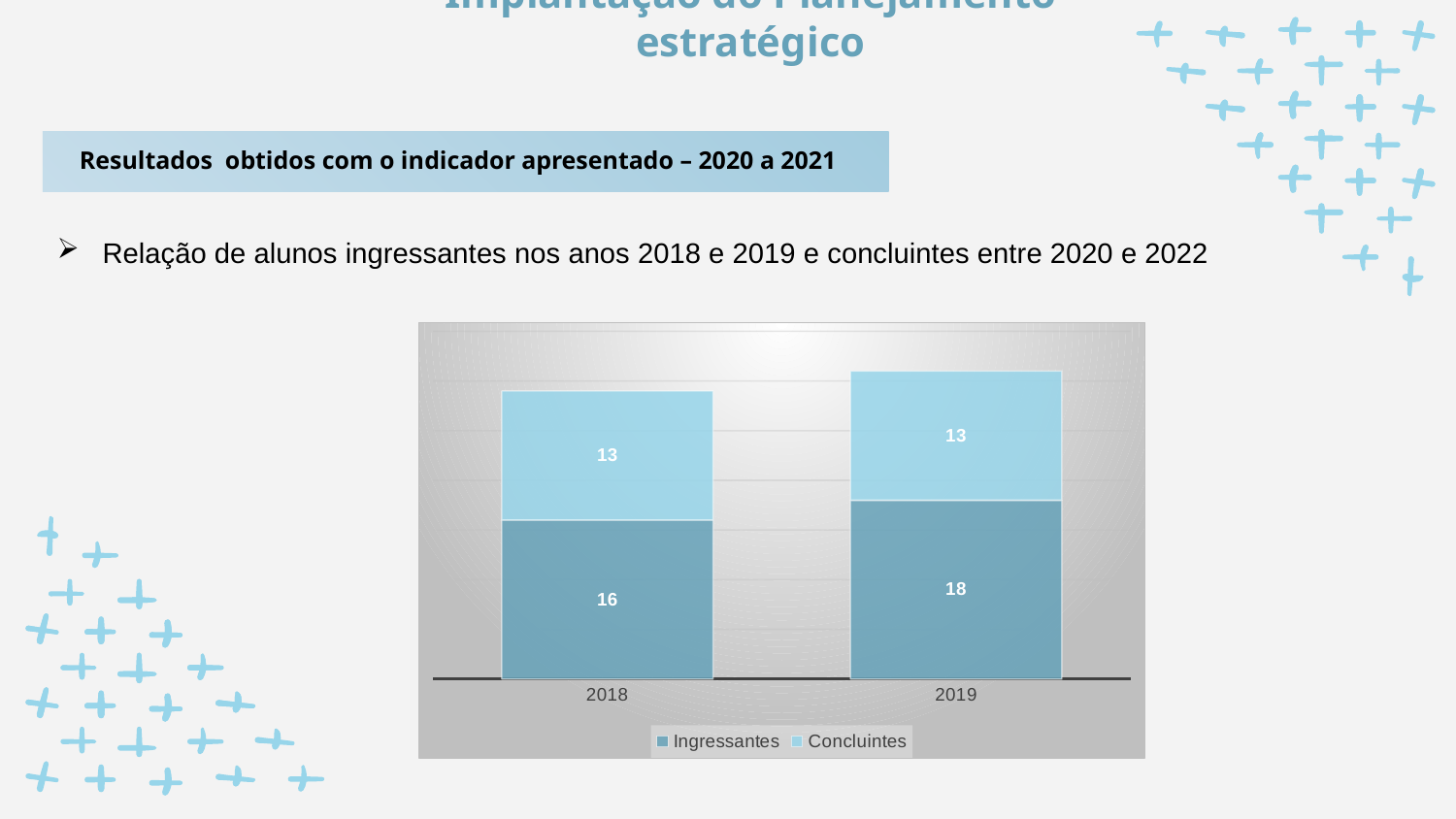
What is the value for Ingressantes in 2019? 18 How many series does the legend list? 2 What is the difference between Ingressantes in 2019 and Ingressantes in 2018? 2 What kind of chart is shown on the slide? Stacked bar chart What is the value for Concluintes in 2019? 13 Which series is shown in the darker blue colour? Ingressantes What is the value for Concluintes in 2018? 13 What is the total of the stacked bar for 2018? 29 What is the total of the stacked bar for 2019? 31 How many categories are shown on the x axis? 2 What is the value for Ingressantes in 2018? 16 Which year has the higher value for Ingressantes, 2018 or 2019? 2019